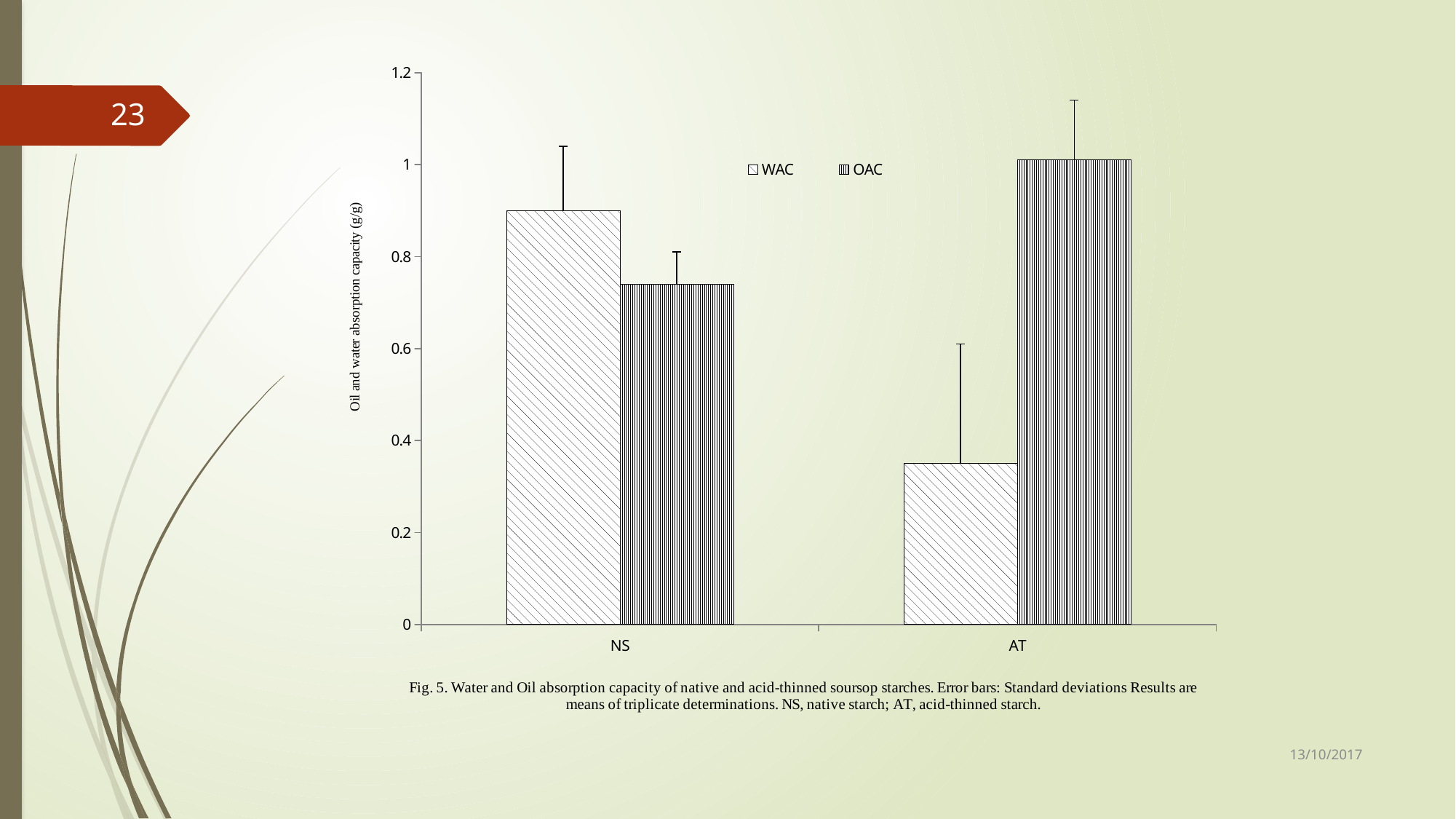
Which series are listed in the legend? WAC and OAC Is the OAC value for NS greater or less than 0.8? less For NS, which is larger, WAC or OAC? WAC Is the OAC value for AT greater or less than 0.8? greater For AT, which is larger, WAC or OAC? OAC Is the WAC value for AT greater or less than 0.4? less How many categories are shown on the x axis? 2 How many series does the legend list? 2 What kind of chart is shown on the slide? bar chart Which bar is the tallest in the chart? OAC for AT What is the label of the y axis? Oil and water absorption capacity (g/g)